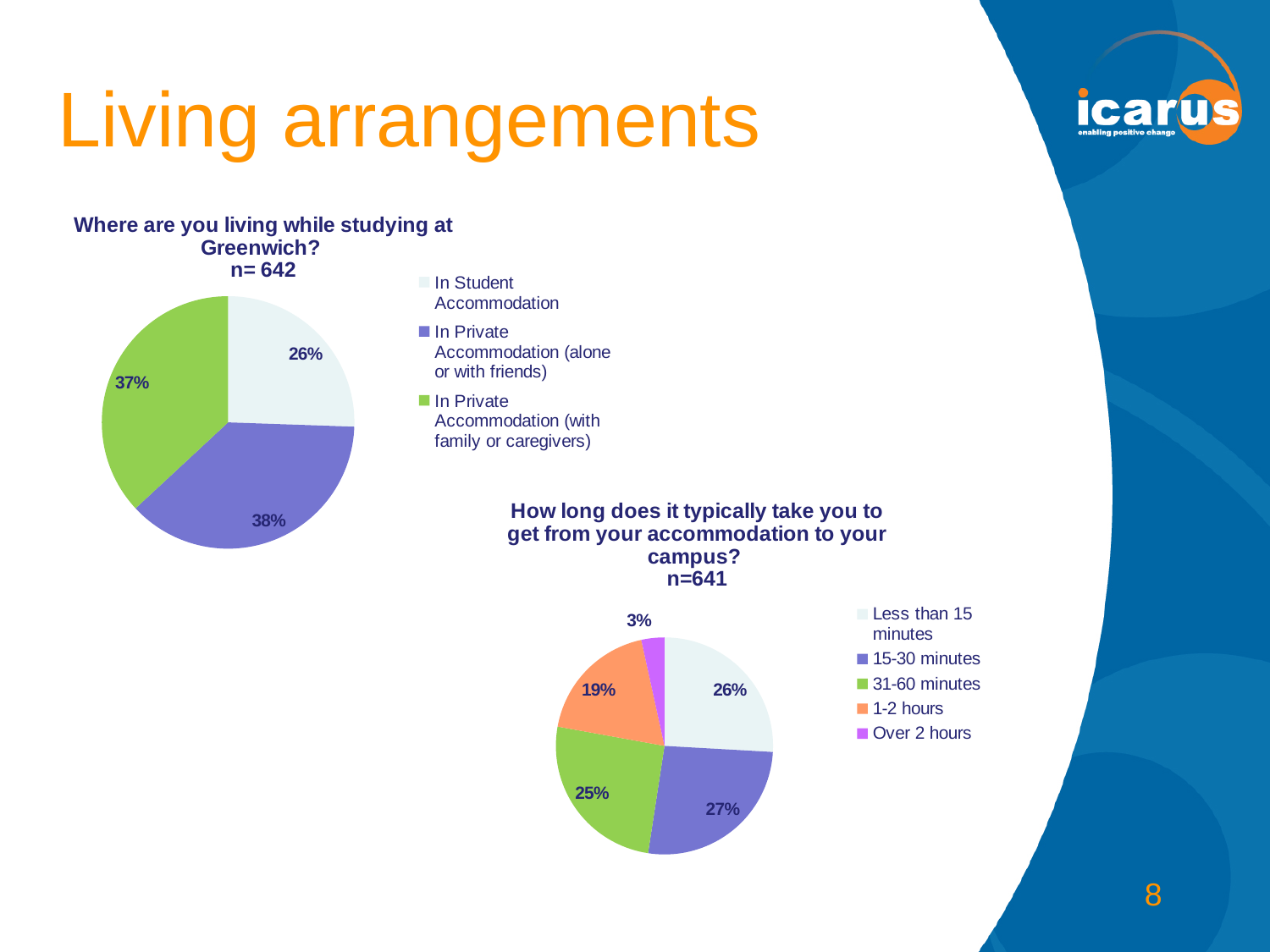
In the 'Where are you living while studying at Greenwich?' pie chart, what percentage are in Private Accommodation (with family or caregivers)? 37% In the 'How long does it typically take you to get from your accommodation to your campus?' pie chart, which is larger: the share for 31-60 minutes or the share for 1-2 hours? 31-60 minutes In the 'How long does it typically take you to get from your accommodation to your campus?' pie chart, which category has the smallest share? Over 2 hours In the 'How long does it typically take you to get from your accommodation to your campus?' pie chart, what percentage take 15-30 minutes? 27% In the 'How long does it typically take you to get from your accommodation to your campus?' pie chart, what percentage take 1-2 hours? 19% In the 'Where are you living while studying at Greenwich?' pie chart, what is the difference between the share in Private Accommodation (alone or with friends) and the share in Student Accommodation? 12% In the 'Where are you living while studying at Greenwich?' pie chart, what percentage are in Private Accommodation (alone or with friends)? 38% In the 'Where are you living while studying at Greenwich?' pie chart, which category has the smallest share? In Student Accommodation In the 'Where are you living while studying at Greenwich?' pie chart, how many slices does the pie have? 3 What type of chart is used for the 'How long does it typically take you to get from your accommodation to your campus?' data? Pie chart In the 'How long does it typically take you to get from your accommodation to your campus?' pie chart, how many categories does the legend list? 5 In the 'Where are you living while studying at Greenwich?' pie chart, what percentage of students are in Student Accommodation? 26%